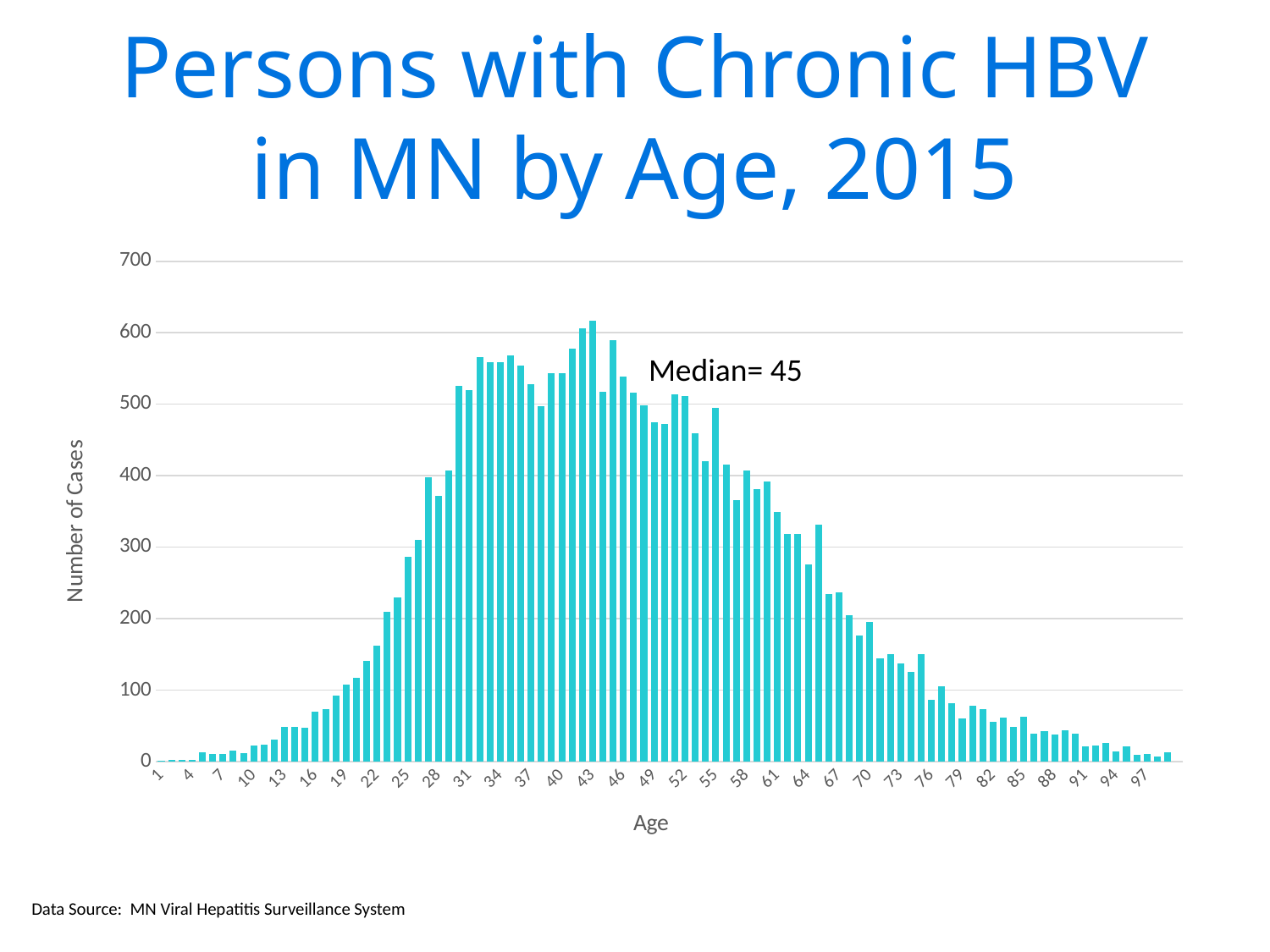
Is the number of cases for age 13 greater or less than 100? less Is the number of cases for age 67 greater or less than 200? greater Is the number of cases for age 43 greater or less than 600? greater Do the number of cases generally rise or fall along the x axis from age 46 to age 97? fall What is the title of the chart? Persons with Chronic HBV in MN by Age, 2015 Which has more cases, age 43 or age 97? age 43 What kind of chart is shown on the slide? bar chart What median value is annotated on the chart? Median= 45